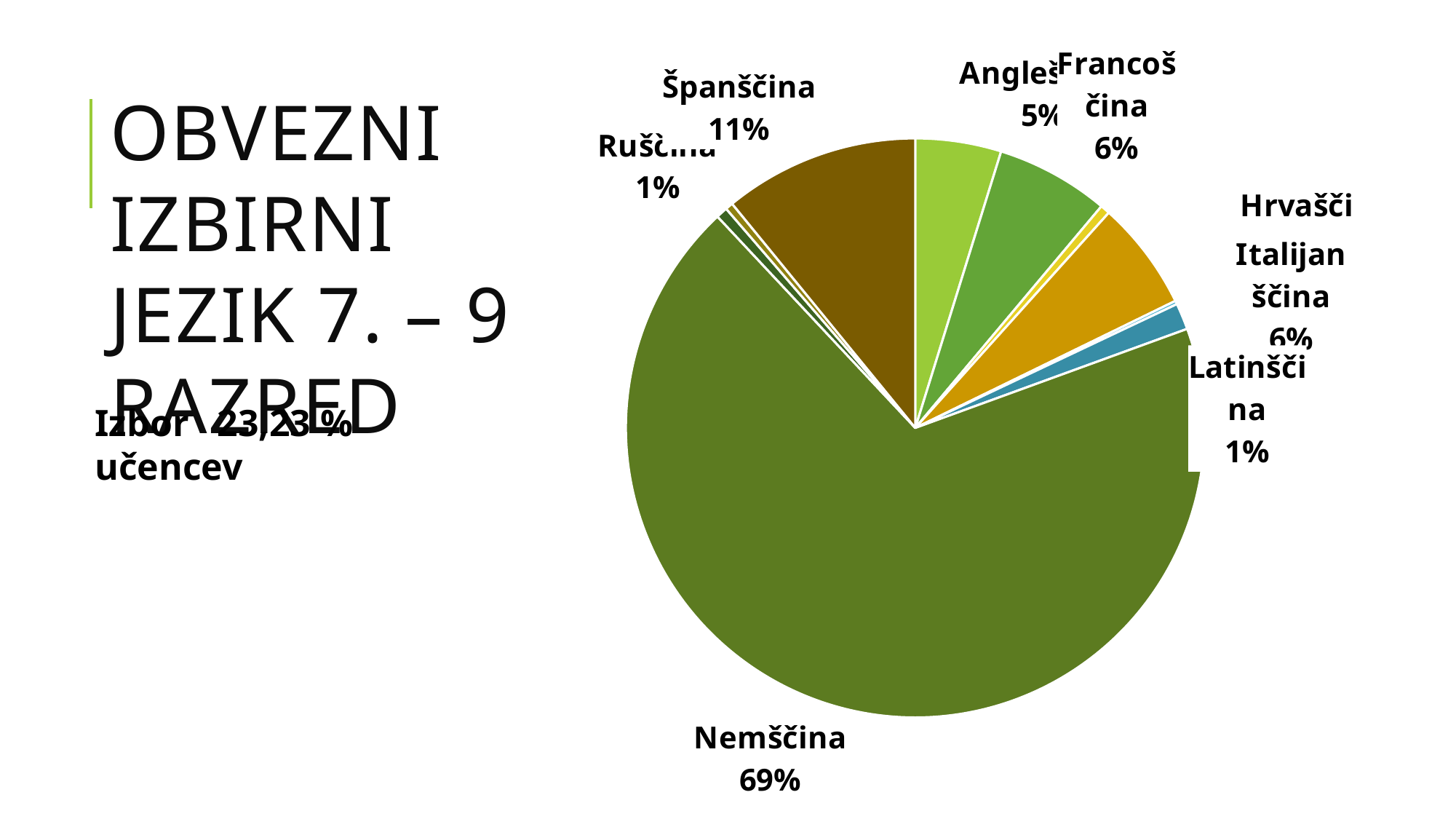
What is the title of the slide containing the pie chart? OBVEZNI IZBIRNI JEZIK 7. – 9 RAZRED What percentage is shown for Španščina? 11% What kind of chart is shown on the slide? pie chart What percentage is shown for Italijanščina? 6% What percentage of the pie is Nemščina? 69% What is the difference in percentage points between Nemščina and Španščina? 58% Which slice is larger, Španščina or Francoščina? Španščina Which language has the largest slice of the pie? Nemščina What percentage is shown for Latinščina? 1% What percentage is shown for Francoščina? 6% What percentage is shown for Ruščina? 1% What share of the pie does Španščina take? 11%